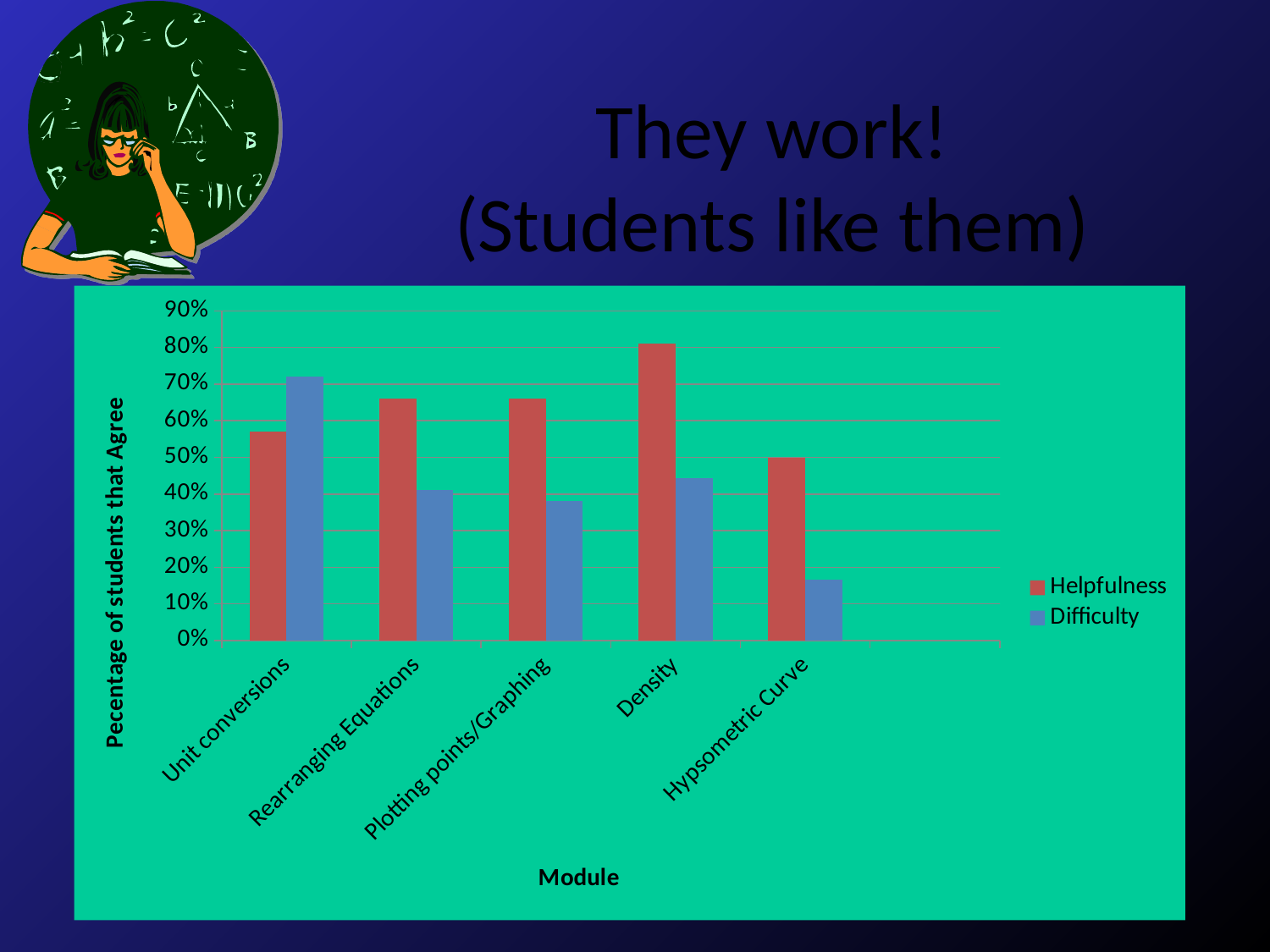
Which module has the highest Difficulty value? Unit conversions For Unit conversions, which is larger: Helpfulness or Difficulty? Difficulty Which module has the highest Helpfulness value? Density Is the Difficulty value for Hypsometric Curve greater or less than 20%? less Which module has the lowest Helpfulness value? Hypsometric Curve For Density, which is larger: Helpfulness or Difficulty? Helpfulness How many series does the chart's legend list? 2 What kind of chart is shown on the slide? bar chart Which module has the lowest Difficulty value? Hypsometric Curve What is the title of the chart's vertical axis? Pecentage of students that Agree How many modules are shown on the x axis of the chart? 5 Is the Helpfulness value for Density greater or less than 70%? greater